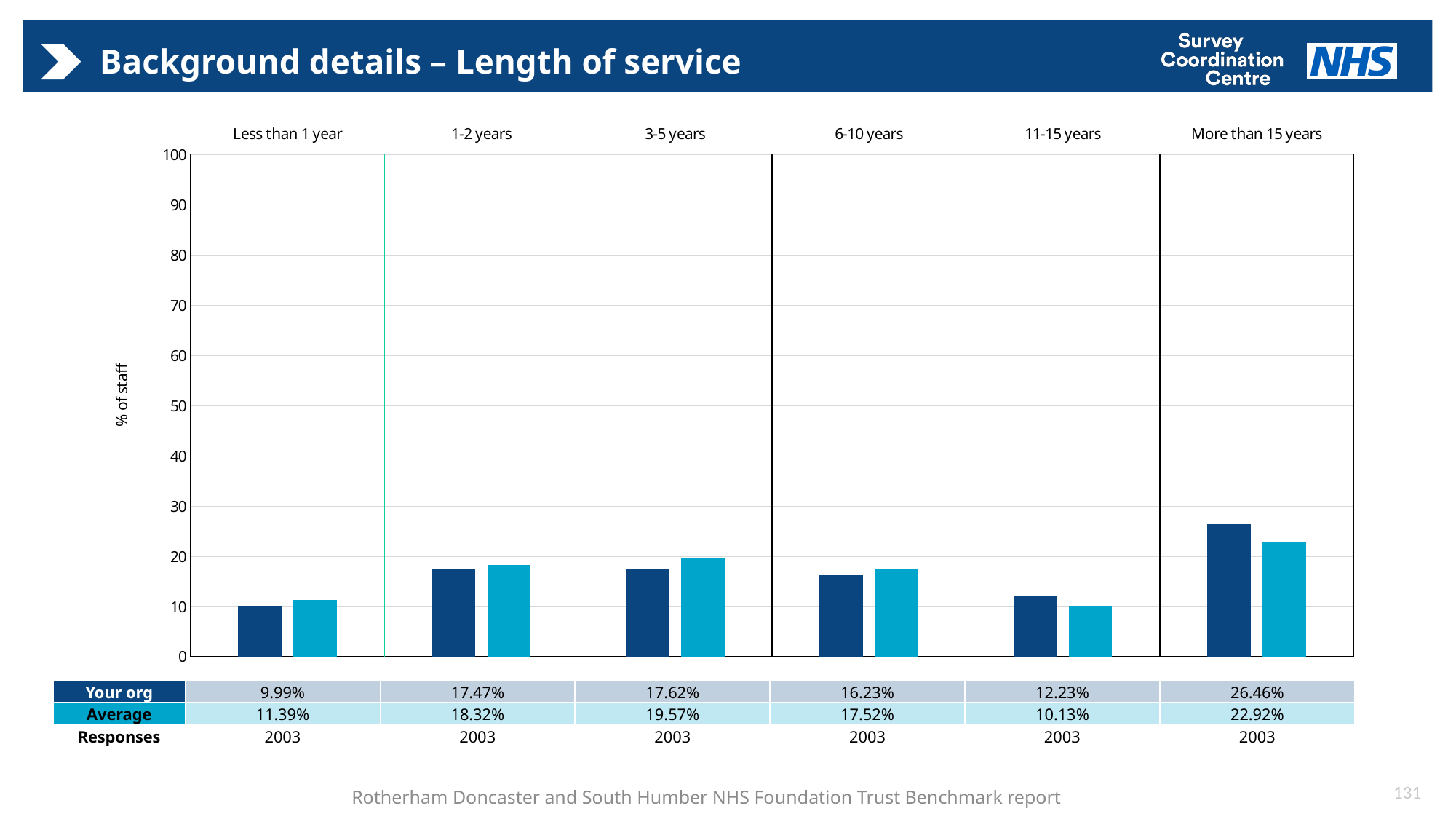
What is the 'Average' value for '3-5 years'? 19.57% How many length-of-service categories are shown on the chart? 6 For '11-15 years', which is larger: 'Your org' or 'Average'? Your org What is the 'Your org' value for 'Less than 1 year'? 9.99% What is the number of responses shown for '1-2 years'? 2003 What is the difference between the 'Your org' and 'Average' values for 'More than 15 years'? 3.54% What is the 'Your org' value for 'More than 15 years'? 26.46% Which length-of-service category has the lowest 'Average' value? 11-15 years What kind of chart is shown on the slide? bar chart How many series does the chart show? 2 Which length-of-service category has the highest 'Your org' value? More than 15 years Is the 'Your org' value for '6-10 years' greater or less than 20? less